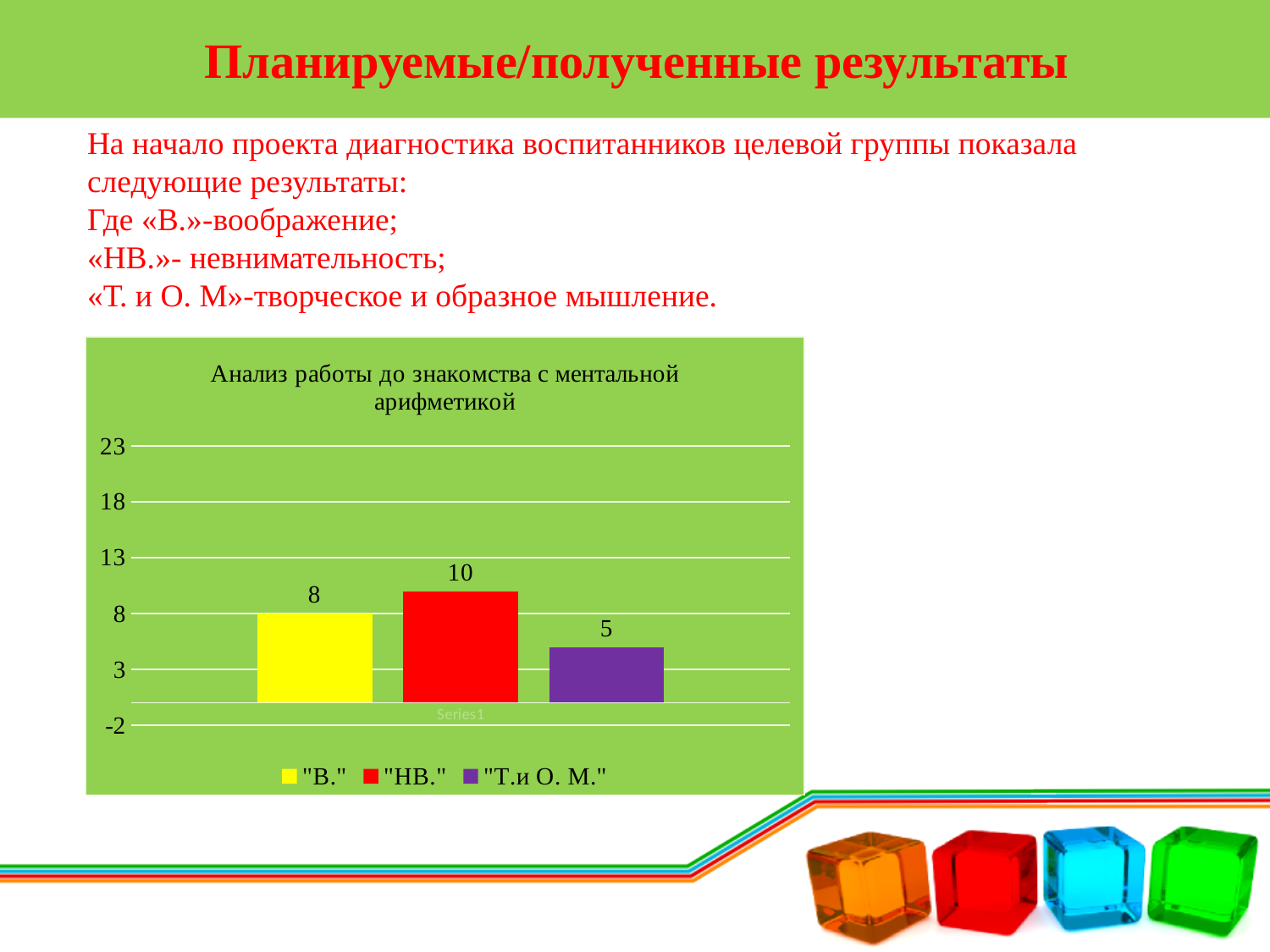
How many series does the legend list? 3 What is the title of the chart? Анализ работы до знакомства с ментальной арифметикой What is the value for "В." in the chart? 8 Which series has the lowest value in the chart? "Т.и О. М." What is the value for "НВ." in the chart? 10 What is the difference between the values for "В." and "Т.и О. М."? 3 Which is larger, the value for "В." or the value for "Т.и О. М."? "В." What is the difference between the values for "НВ." and "В."? 2 What is the value for "Т.и О. М." in the chart? 5 Which series has the highest value in the chart? "НВ." What kind of chart is shown on the slide? bar chart Is the value for "НВ." greater or less than 13? less